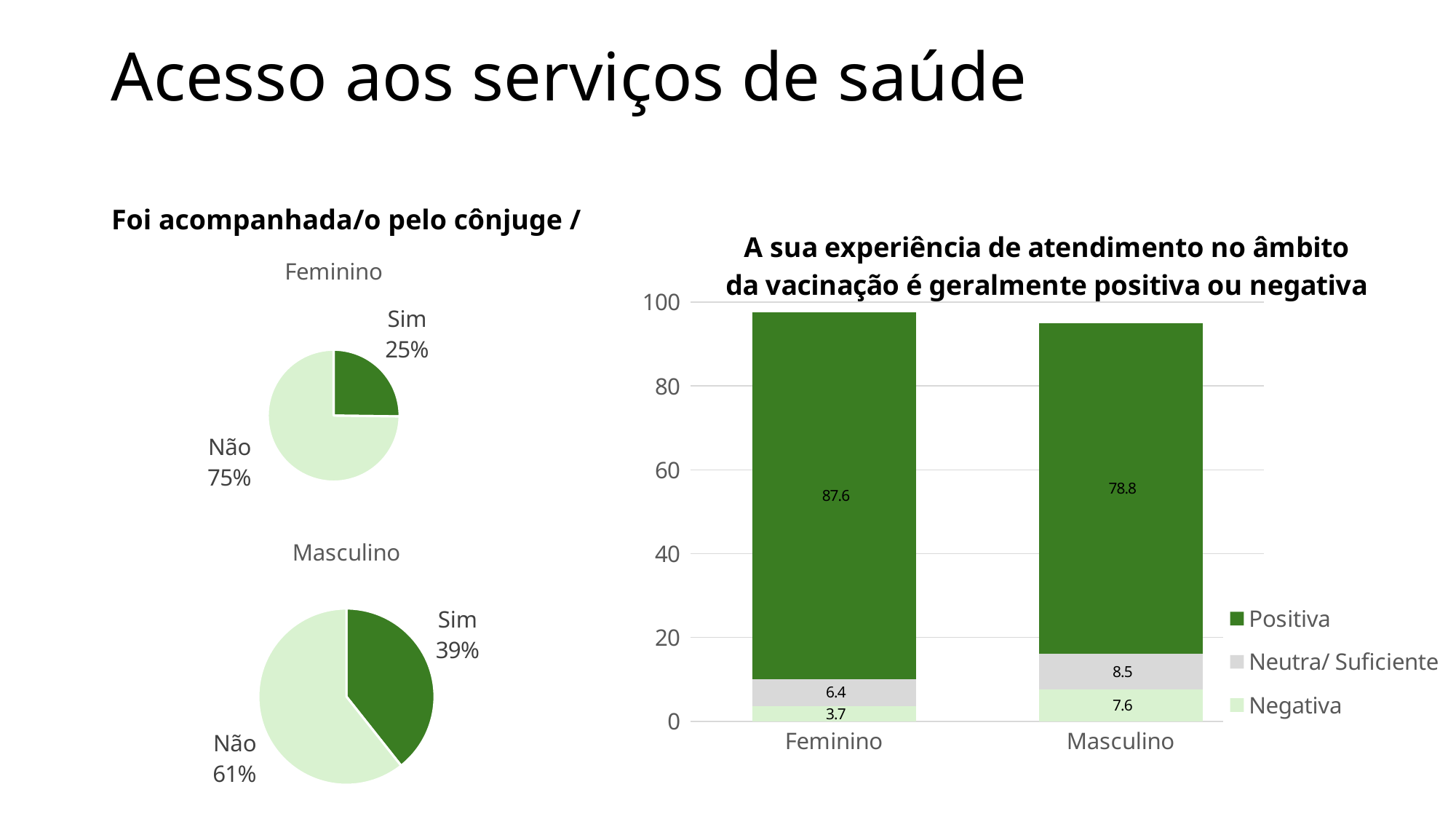
In the stacked bar chart on the right, what is the difference between the Positiva values for Feminino and Masculino? 8.8 In the stacked bar chart on the right, what is the Positiva value for Feminino? 87.6 What kind of chart is the chart on the right of the slide? Stacked bar chart In the Feminino pie chart, what percentage answered Não? 75% In the stacked bar chart on the right, what is the total of the Masculino bar? 94.9 How many series does the legend of the stacked bar chart on the right list? 3 In the Feminino pie chart, what percentage answered Sim? 25% In the stacked bar chart on the right, what is the Neutra/ Suficiente value for Masculino? 8.5 In the Masculino pie chart, what percentage answered Sim? 39% In the Masculino pie chart, what is the difference between the Não and Sim shares? 22% In the Masculino pie chart, which slice is larger, Sim or Não? Não In the stacked bar chart on the right, what is the Negativa value for Feminino? 3.7